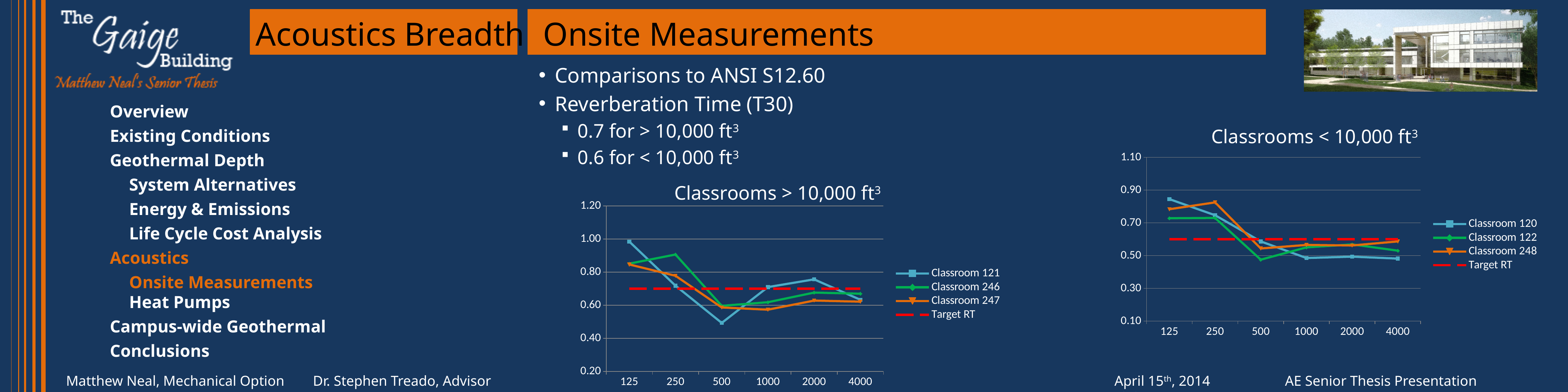
Which legend entry in the 'Classrooms > 10,000 ft³' chart is drawn as a red dashed line? Target RT In the 'Classrooms > 10,000 ft³' chart, is the value for Classroom 121 at 500 greater or less than 0.60? less In the 'Classrooms < 10,000 ft³' chart, is the value for Classroom 120 at 125 greater or less than 0.70? greater In the 'Classrooms > 10,000 ft³' chart, which series has the highest value at 125? Classroom 121 In the 'Classrooms > 10,000 ft³' chart, at 500, which is larger: Classroom 121 or Classroom 246? Classroom 246 In the 'Classrooms < 10,000 ft³' chart, at 125, which is larger: Classroom 120 or Classroom 122? Classroom 120 What kind of chart is the 'Classrooms > 10,000 ft³' chart? line chart In the 'Classrooms < 10,000 ft³' chart, does the Classroom 120 line rise or fall from 125 to 500? fall In the 'Classrooms < 10,000 ft³' chart, is the value for Classroom 122 at 500 greater or less than 0.50? less How many frequency points are plotted along the x axis of the 'Classrooms > 10,000 ft³' chart? 6 How many series does the legend of the 'Classrooms < 10,000 ft³' chart list? 4